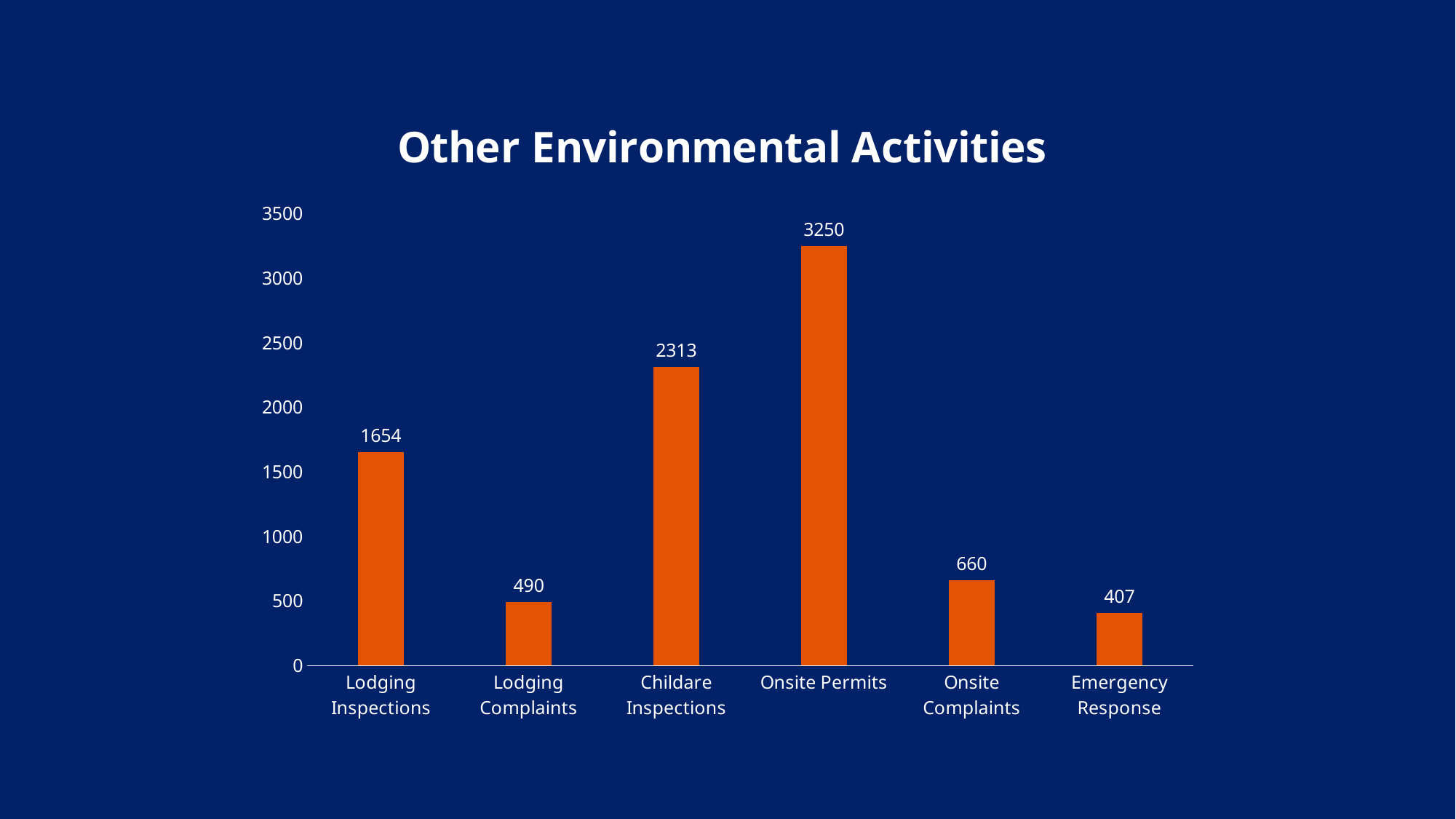
What is the title of the chart? Other Environmental Activities What is the difference between Onsite Complaints and Lodging Complaints? 170 Which category has the highest value? Onsite Permits What is the value for Lodging Inspections? 1654 What kind of chart is shown on the slide? bar chart What is the difference between Onsite Permits and Childare Inspections? 937 Which is larger, Lodging Inspections or Childare Inspections? Childare Inspections What is the value for Onsite Permits? 3250 How many categories are shown in the chart? 6 Is the value for Lodging Complaints greater or less than 500? less What is the value for Emergency Response? 407 Which category has the lowest value? Emergency Response